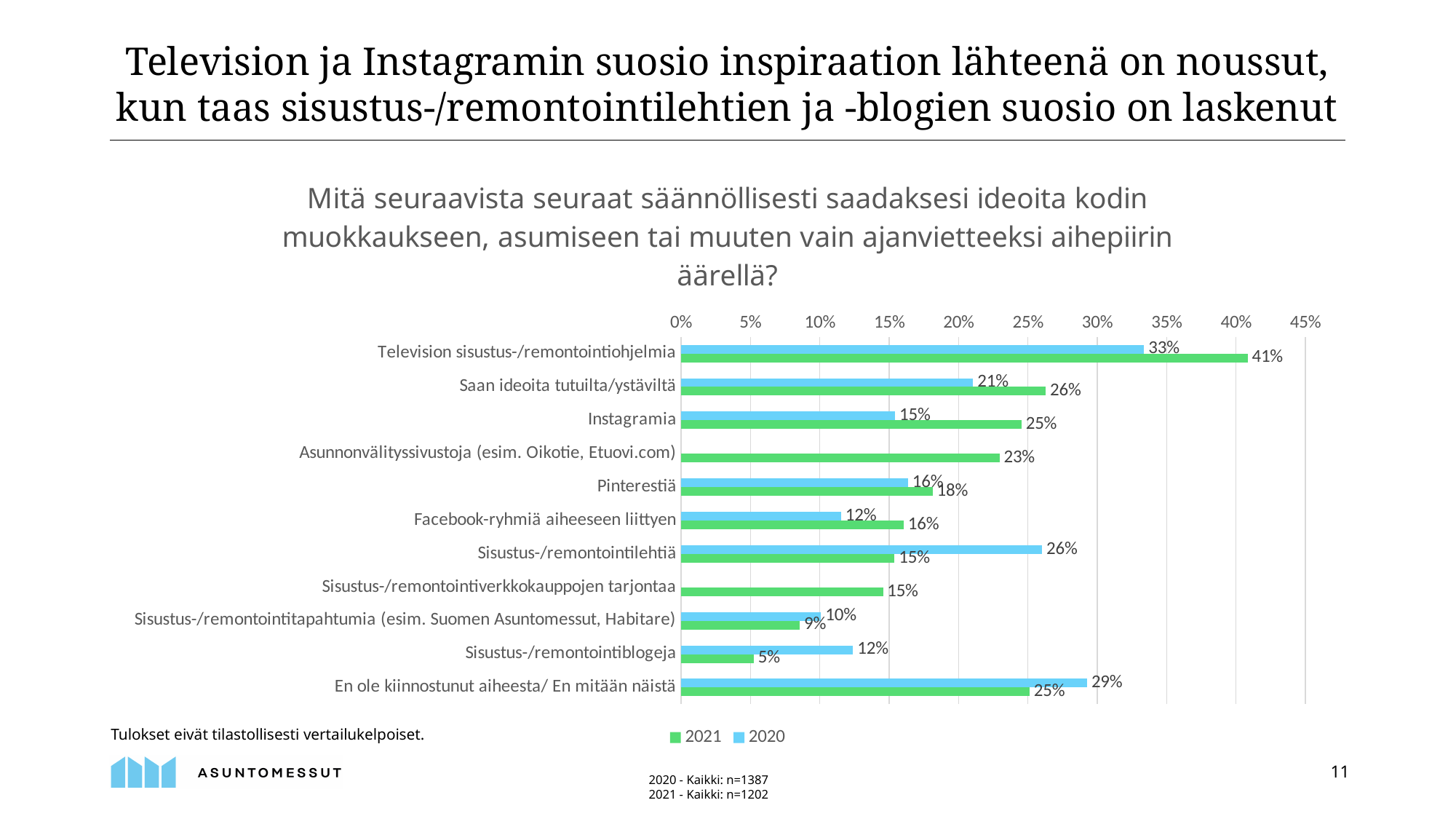
Which category has the lowest 2021 value? Sisustus-/remontointiblogeja How many series does the legend list? 2 What is the difference between the 2021 and 2020 values for Instagramia? 10 percentage points Which colour represents the 2021 series in the legend? Green What kind of chart is shown on the slide? Bar chart What is the 2021 value for Television sisustus-/remontointiohjelmia? 41% For Sisustus-/remontointiblogeja, which year has the larger value, 2020 or 2021? 2020 What is the 2021 value for Asunnonvälityssivustoja (esim. Oikotie, Etuovi.com)? 23% What is the 2020 value for Instagramia? 15% Which category has the highest 2021 value? Television sisustus-/remontointiohjelmia What is the 2020 value for Sisustus-/remontointilehtiä? 26% How many categories are shown on the chart? 11